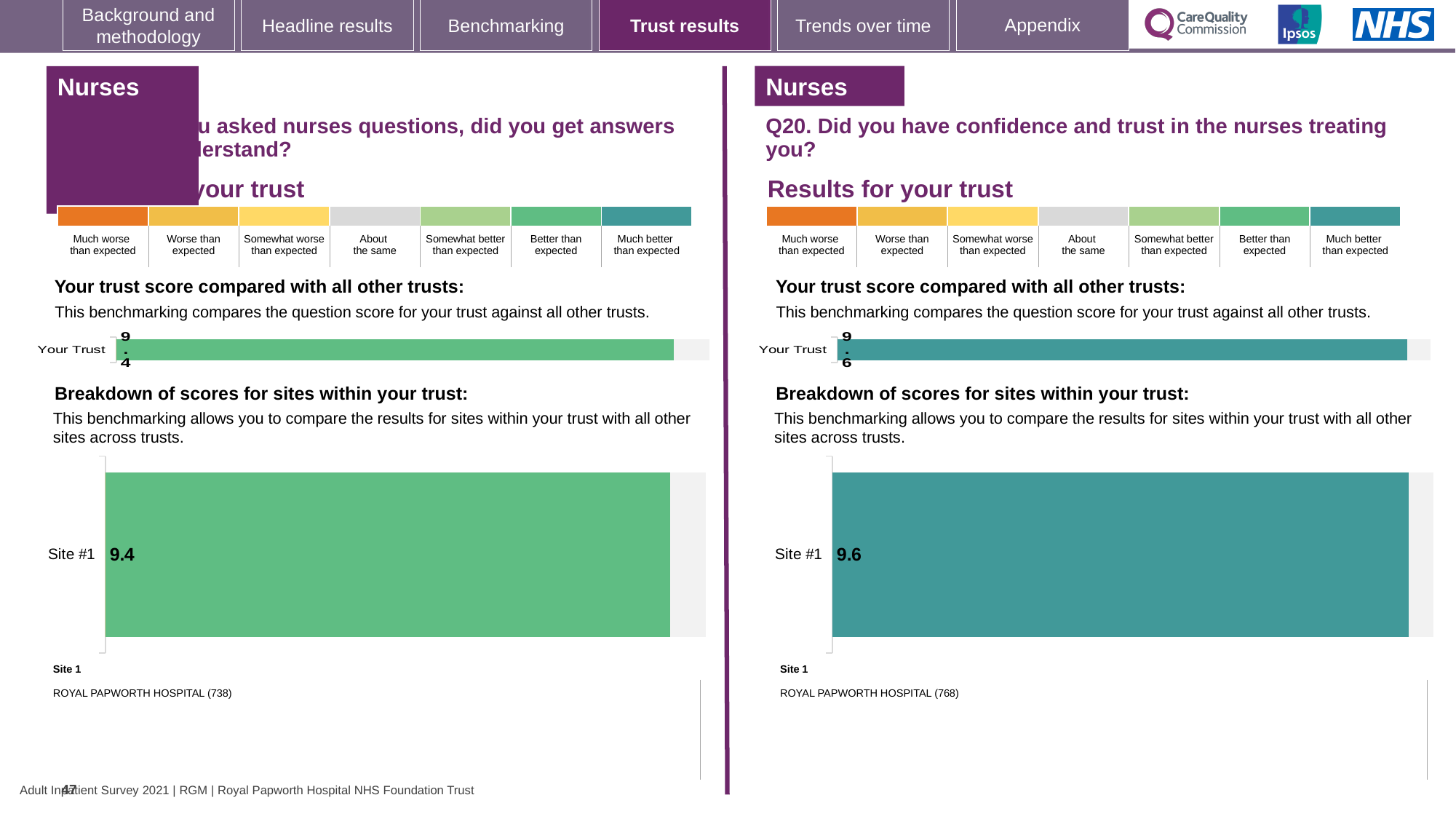
How many sites are shown in the breakdown of scores chart on the left panel? 1 What kind of chart is used to show the Site #1 score on the right panel (Q20)? Bar chart What is the difference between the Site #1 score on the right panel (Q20) and the Site #1 score on the left panel? 0.2 On the right panel (Q20), which hospital is listed as Site 1? ROYAL PAPWORTH HOSPITAL (768) On the left panel, which hospital is listed as Site 1? ROYAL PAPWORTH HOSPITAL (738) On the right panel (Q20), what is the score shown for Site #1 in the breakdown of scores for sites within your trust? 9.6 Which Site #1 score is larger: the one on the left panel or the one on the right panel (Q20)? Right panel (Q20) On the right panel (Q20), what is the value shown for 'Your Trust' in the trust score comparison bar? 9.6 On the left panel, what is the score shown for Site #1 in the breakdown of scores for sites within your trust? 9.4 On the left panel, what is the value shown for 'Your Trust' in the trust score comparison bar? 9.4 How many sites are shown in the breakdown of scores chart on the right panel (Q20)? 1 Is the Site #1 score on the left panel greater or less than 9.6? less